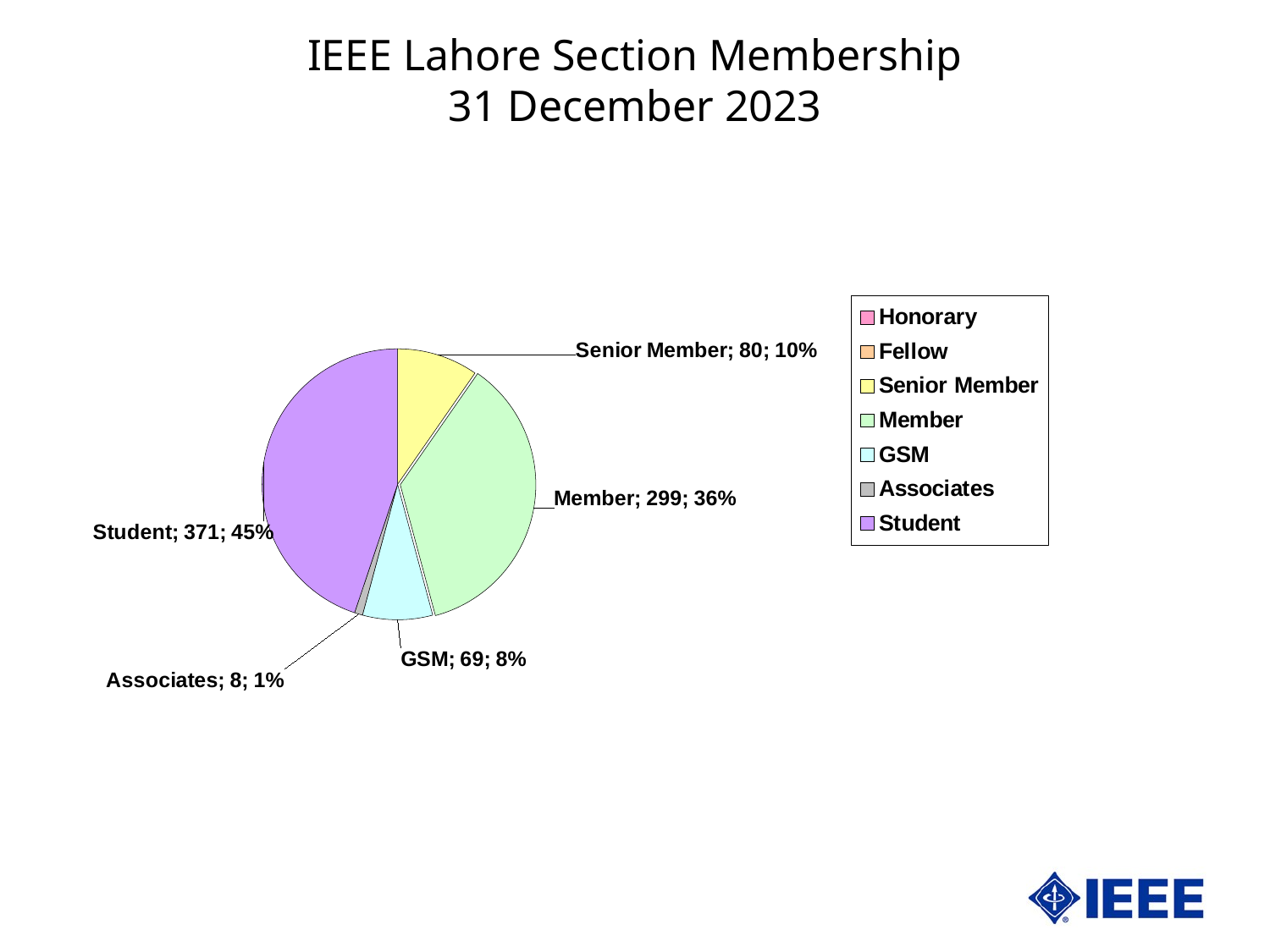
How many members does the Student slice represent? 371 What percentage of the pie is the Member slice? 36% What is the difference between the Student count and the Member count? 72 Which is larger, the Senior Member count or the GSM count? Senior Member What share of the pie do Associates make up? 1% What is the value shown for Senior Member? 80 What colour is the Student slice in the pie chart? purple Which category has the largest slice of the pie? Student What kind of chart is shown on the slide? pie chart Which labelled category has the smallest slice of the pie? Associates How many entries does the legend list? 7 What is the value shown for GSM? 69